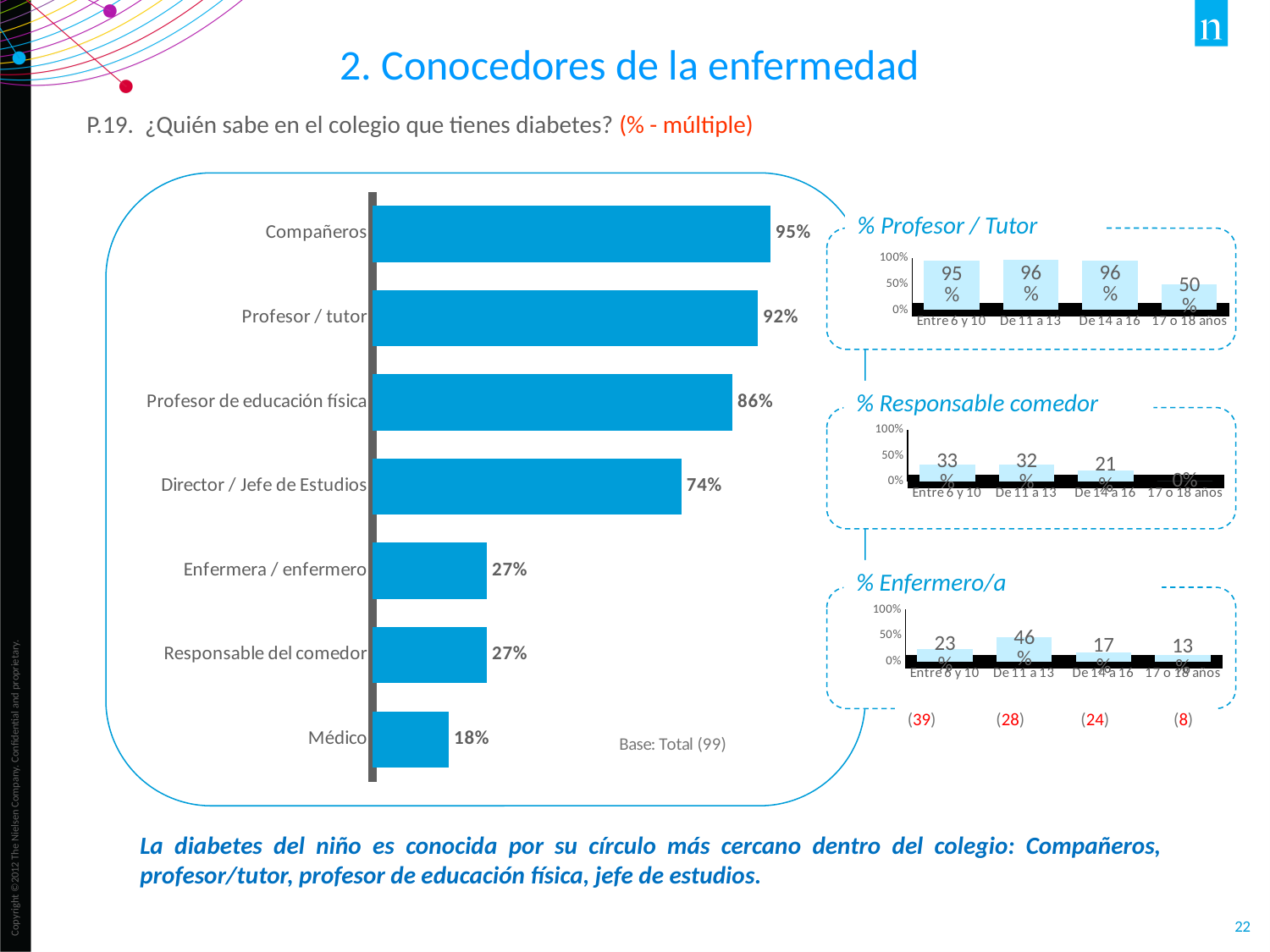
In the '% Enfermero/a' chart, what is the difference between the values for De 11 a 13 and Entre 6 y 10? 23% In the '% Profesor / Tutor' chart, what is the value for 17 o 18 años? 50% What kind of chart is the main chart on the left of the slide? Bar chart In the main bar chart, which is larger: the value for Director / Jefe de Estudios or the value for Enfermera / enfermero? Director / Jefe de Estudios In the main bar chart, what is the difference between the values for Profesor / tutor and Profesor de educación física? 6% In the main bar chart, what is the value for Compañeros? 95% In the main bar chart, which category has the highest value? Compañeros In the '% Enfermero/a' chart, which age group has the highest value? De 11 a 13 In the main bar chart, what is the value for Director / Jefe de Estudios? 74% How many categories does the main bar chart show? 7 In the main bar chart, which category has the lowest value? Médico In the '% Responsable comedor' chart, what is the value for Entre 6 y 10? 33%